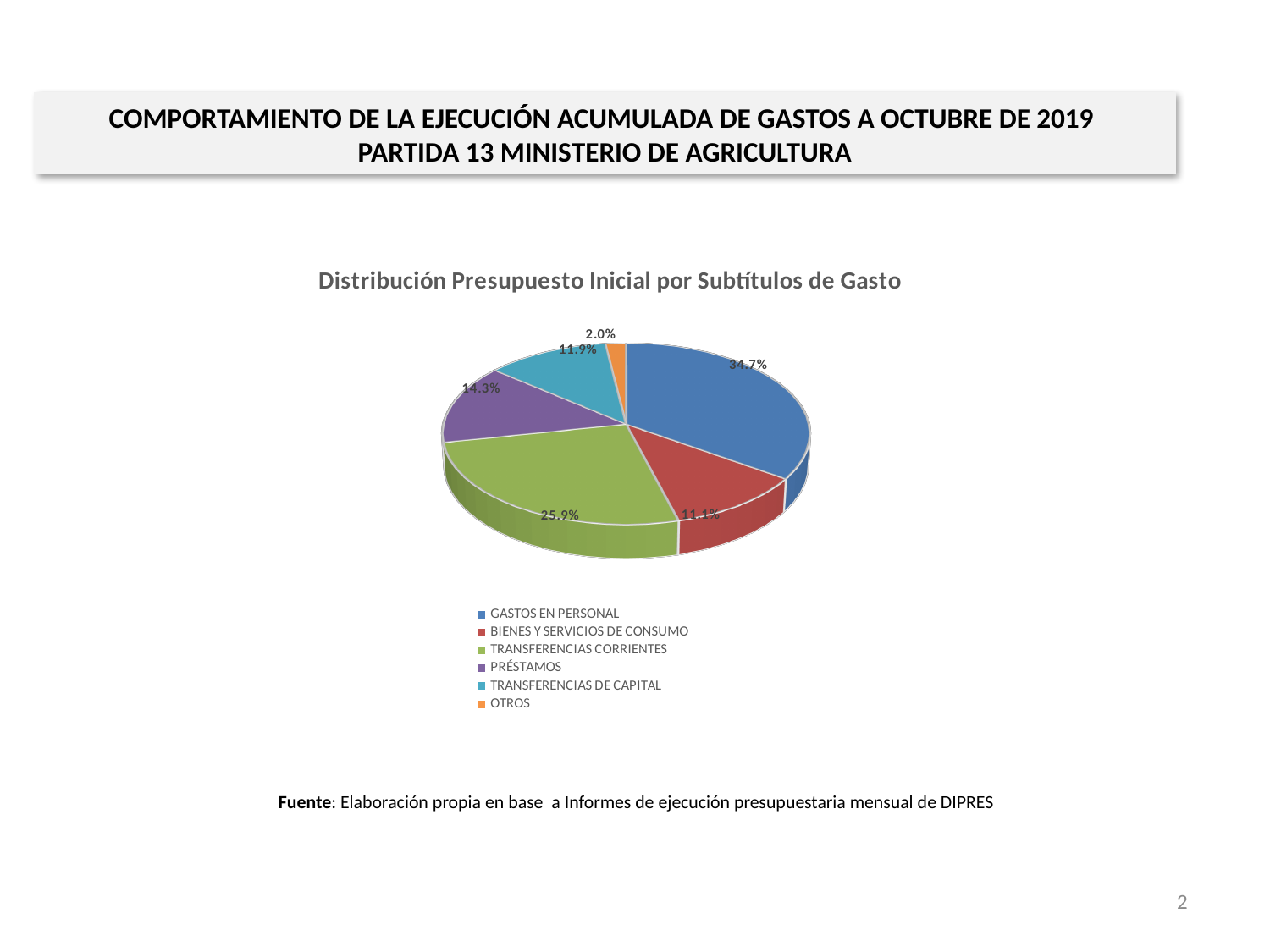
What percentage does the OTROS slice show? 2.0% What percentage is shown for TRANSFERENCIAS CORRIENTES? 25.9% What is the title of the chart? Distribución Presupuesto Inicial por Subtítulos de Gasto What type of chart is shown on the slide? Pie chart Which is larger, the share for PRÉSTAMOS or the share for TRANSFERENCIAS DE CAPITAL? PRÉSTAMOS Which legend entry is shown in orange? OTROS What is the value labelled for PRÉSTAMOS? 14.3% Which category has the largest slice of the pie? GASTOS EN PERSONAL What is the difference in percentage points between GASTOS EN PERSONAL and TRANSFERENCIAS CORRIENTES? 8.8 What share of the pie does GASTOS EN PERSONAL represent? 34.7% Which category has the smallest slice of the pie? OTROS How many slices does the pie chart have? 6